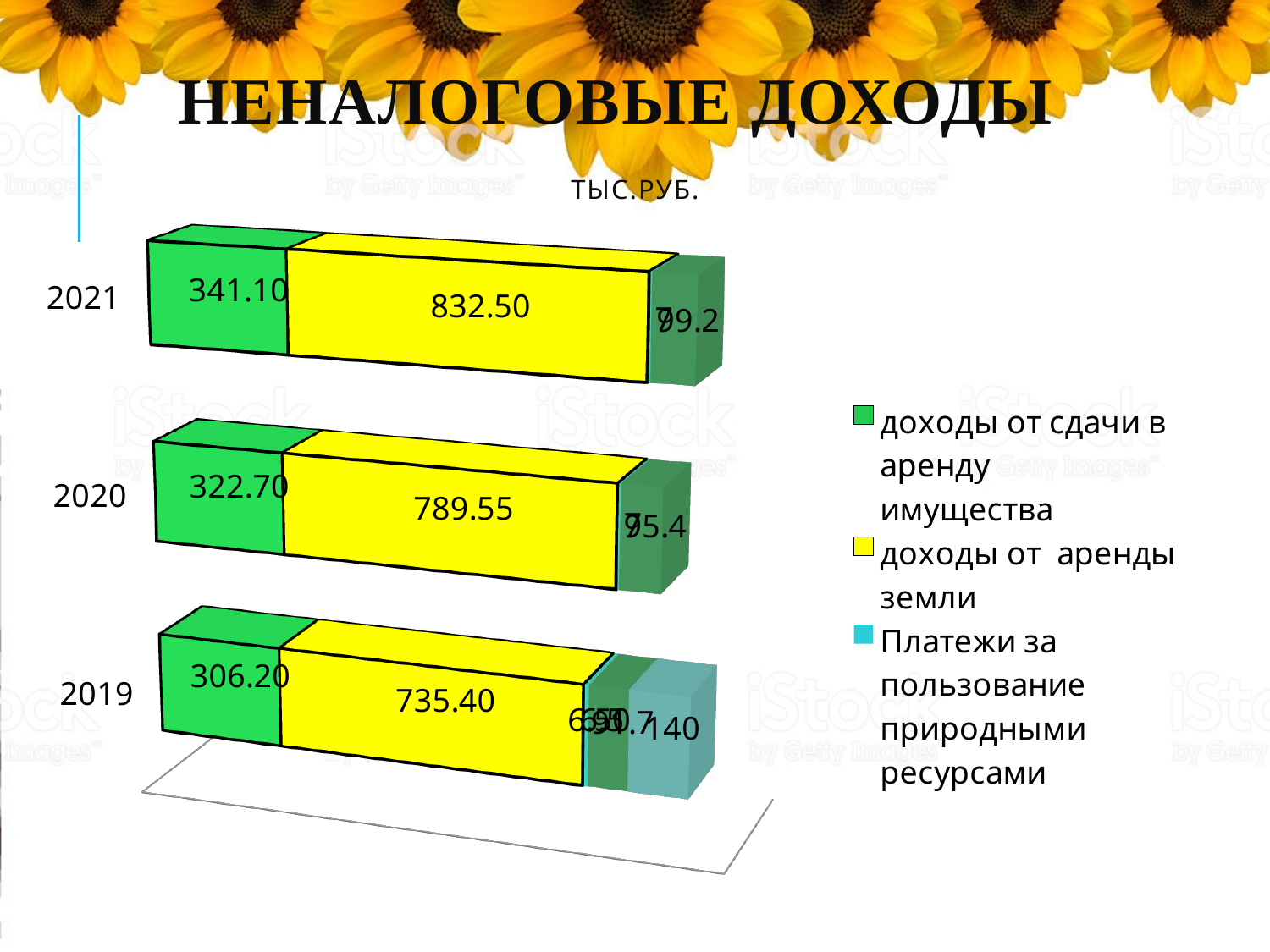
What is the difference between доходы от аренды земли in 2021 and in 2019? 97.10 In which year is доходы от сдачи в аренду имущества the lowest? 2019 How many years are shown in the chart? 3 What is the value of доходы от сдачи в аренду имущества for 2019? 306.20 Does доходы от сдачи в аренду имущества rise or fall from 2019 to 2021? Rises In which year is доходы от аренды земли the highest? 2021 What kind of chart is shown on the slide? Stacked bar chart What is the value of доходы от аренды земли for 2021? 832.50 How many series does the legend list? 3 What is the value of доходы от аренды земли for 2020? 789.55 What is the value of доходы от сдачи в аренду имущества for 2021? 341.10 Which year has the larger value for доходы от сдачи в аренду имущества, 2020 or 2019? 2020